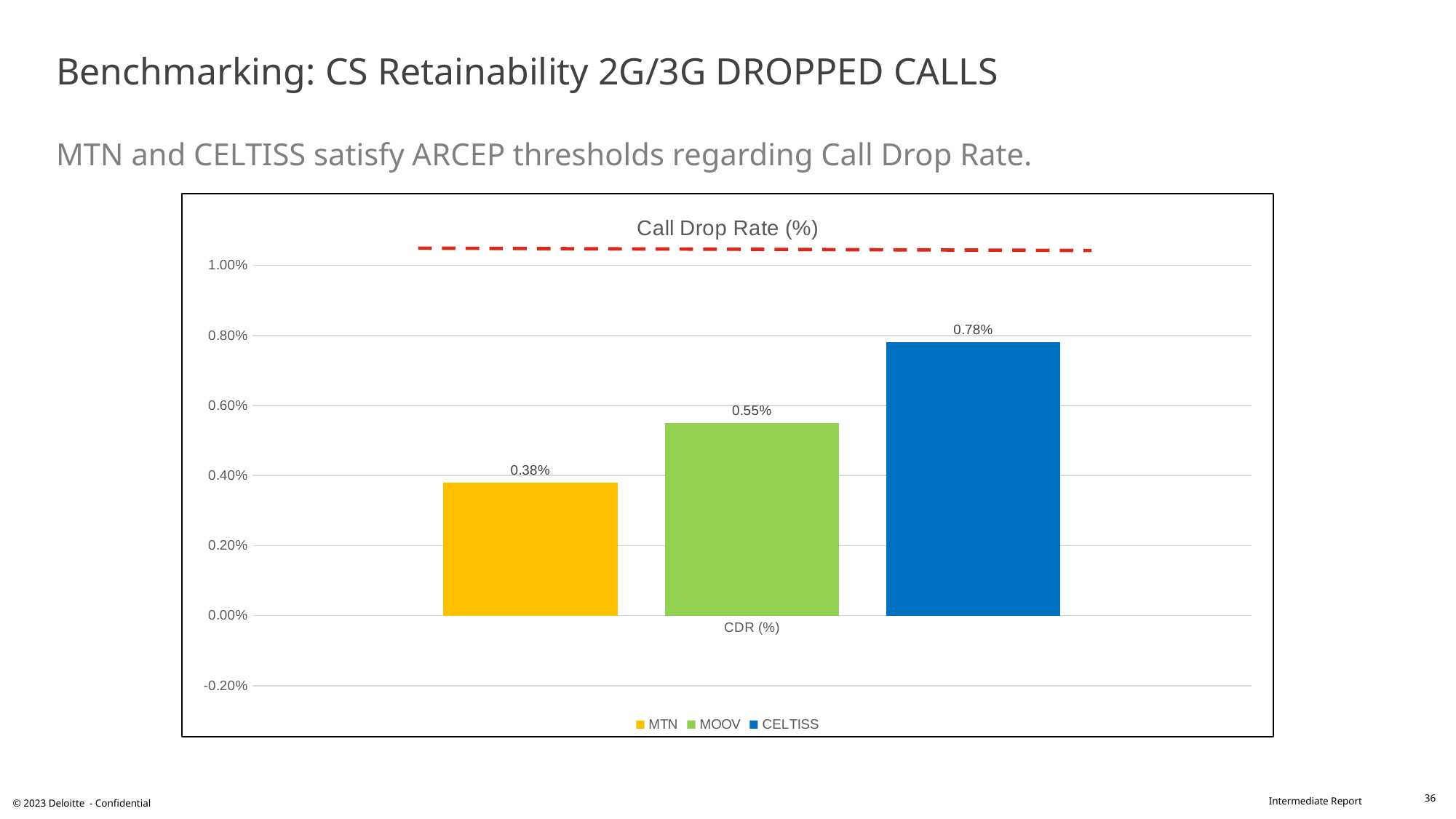
Which has a higher Call Drop Rate, MOOV or CELTISS? CELTISS How many series does the legend list? 3 What is the title of the chart? Call Drop Rate (%) What is the difference between the Call Drop Rate of MOOV and MTN? 0.17% Is the Call Drop Rate for CELTISS greater or less than 1.00%? less Which operator has the highest Call Drop Rate? CELTISS What is the Call Drop Rate for MTN? 0.38% What is the difference between the Call Drop Rate of CELTISS and MTN? 0.40% Which operator has the lowest Call Drop Rate? MTN What kind of chart is shown on the slide? Bar chart What is the Call Drop Rate for CELTISS? 0.78% What is the Call Drop Rate for MOOV? 0.55%